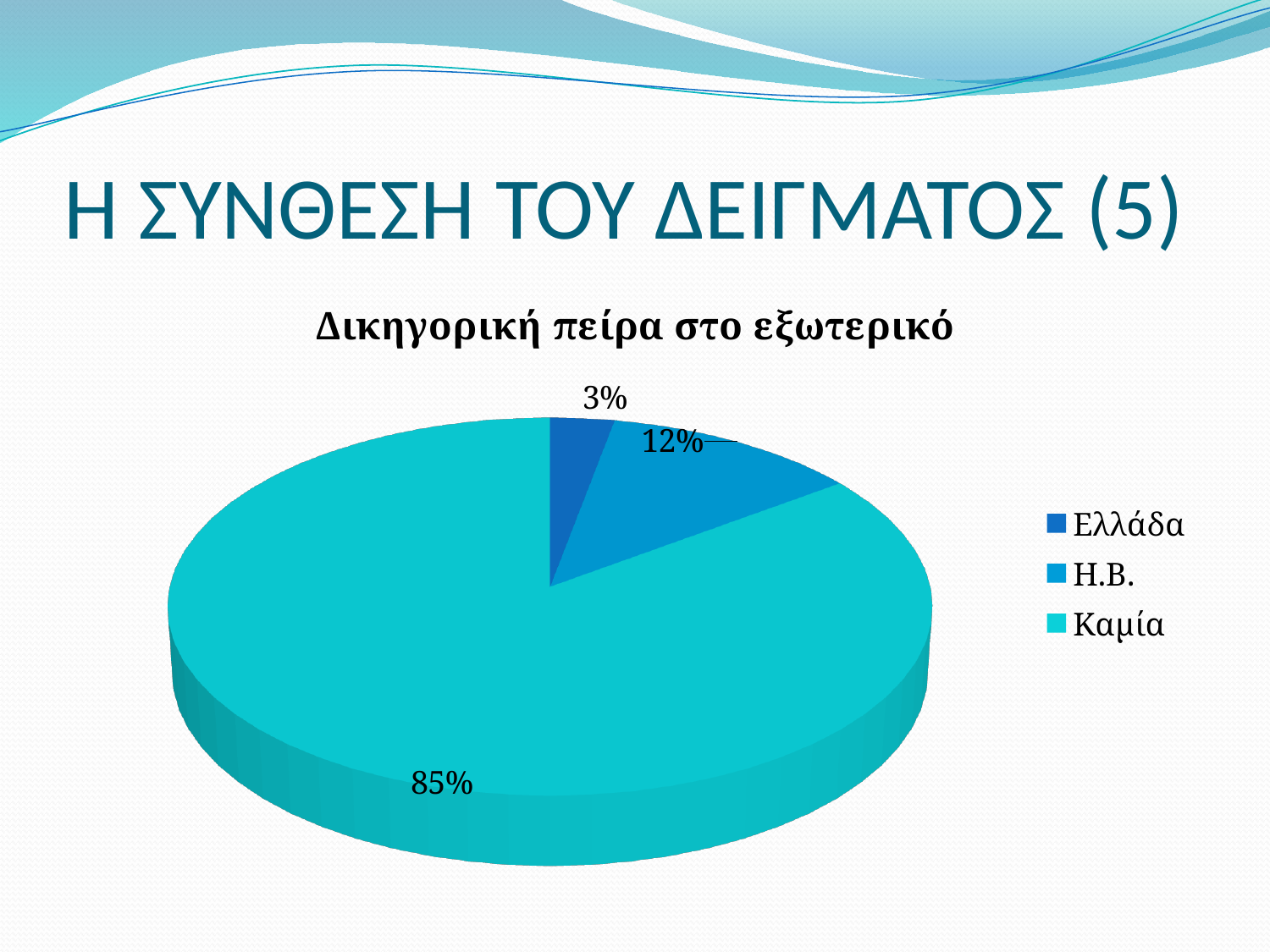
What percentage is shown for Η.Β.? 12% What is the difference in percentage points between Η.Β. and Ελλάδα? 9 What is the difference in percentage points between Καμία and Η.Β.? 73 Which category has the largest share of the pie? Καμία What colour is the slice for Καμία? turquoise Which is larger, the share for Η.Β. or the share for Ελλάδα? Η.Β. How many categories does the legend list? 3 What percentage is shown for Ελλάδα? 3% What is the title of the chart? Δικηγορική πείρα στο εξωτερικό What percentage is shown for Καμία? 85% Which category has the smallest share of the pie? Ελλάδα What type of chart is shown on the slide? pie chart